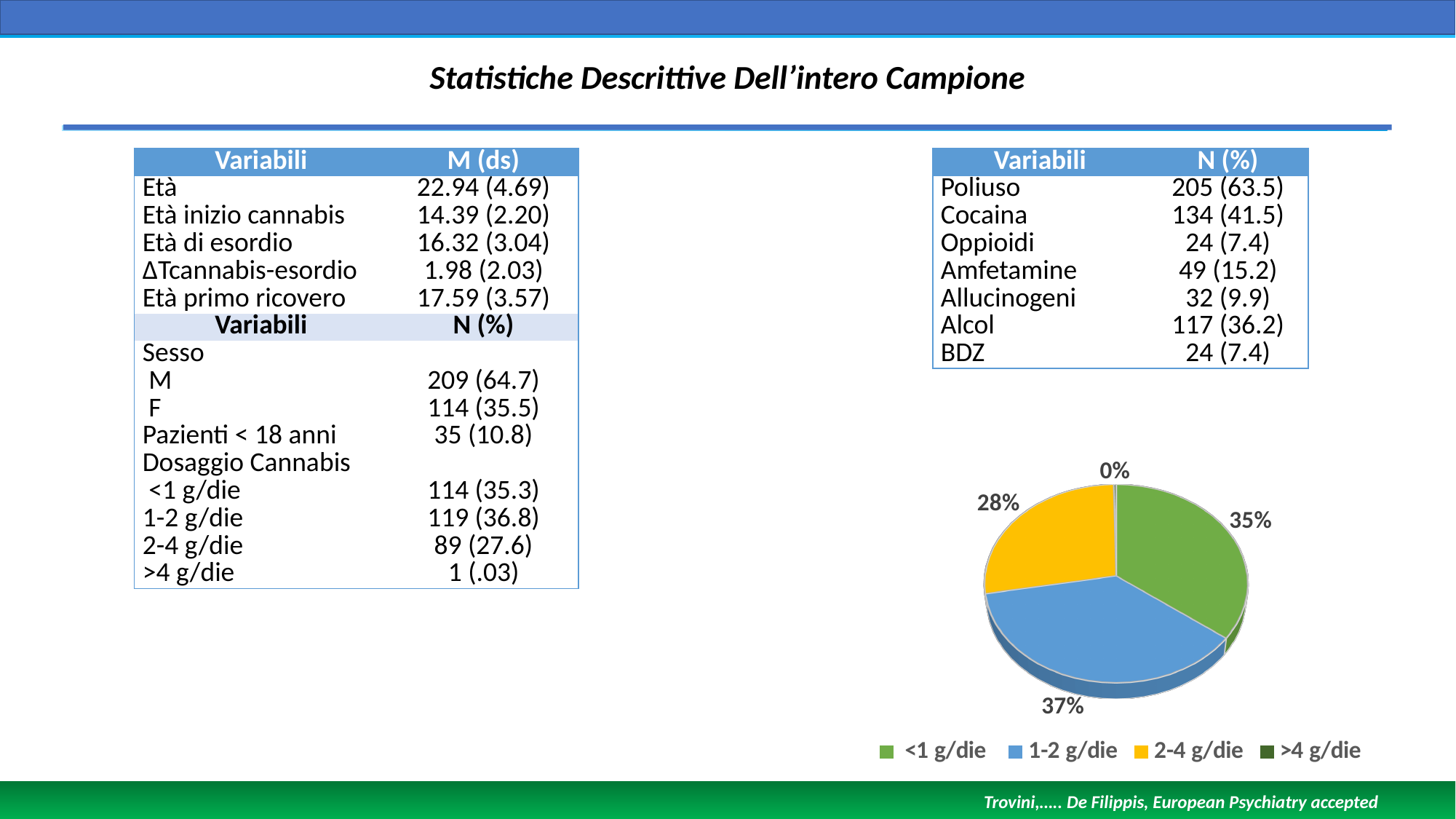
Which slice is larger in the pie chart, <1 g/die or 2-4 g/die? <1 g/die In the pie chart, what share is shown for the <1 g/die slice? 35% In the pie chart, what share is shown for the 2-4 g/die slice? 28% What is the difference in percentage points between the 1-2 g/die slice and the 2-4 g/die slice? 9 Which category has the largest slice in the pie chart? 1-2 g/die What colour is the 1-2 g/die slice in the pie chart? blue How many categories does the pie chart's legend list? 4 In the pie chart, what share is shown for the 1-2 g/die slice? 37% What colour is the 2-4 g/die slice in the pie chart? yellow What kind of chart is shown on the slide? pie chart Which category has the smallest slice in the pie chart? >4 g/die